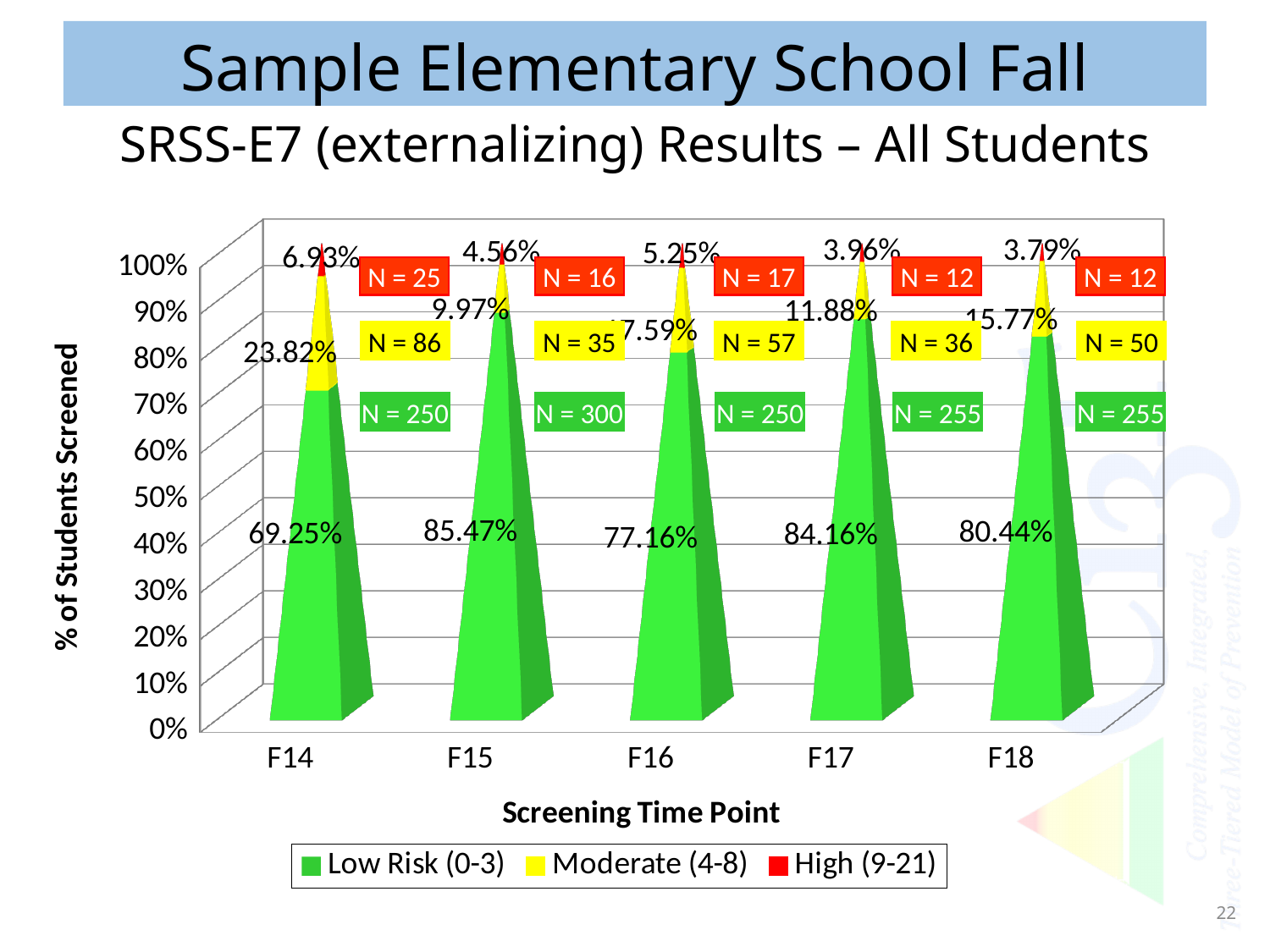
What is the N shown for the Low Risk (0-3) group at F15? N = 300 What percentage of students were Low Risk (0-3) at F15? 85.47% What kind of chart is shown on the slide? Stacked bar chart At which screening time point was the Low Risk (0-3) percentage highest? F15 What percentage of students were Moderate (4-8) at F18? 15.77% How many series does the legend list? 3 Which time point had a larger Moderate (4-8) percentage, F14 or F17? F14 What percentage of students were High (9-21) at F14? 6.93% What is the title of the x axis? Screening Time Point How much higher was the Low Risk (0-3) percentage at F15 than at F14? 16.22% At which screening time point was the Low Risk (0-3) percentage lowest? F14 How many screening time points are shown on the x axis? 5